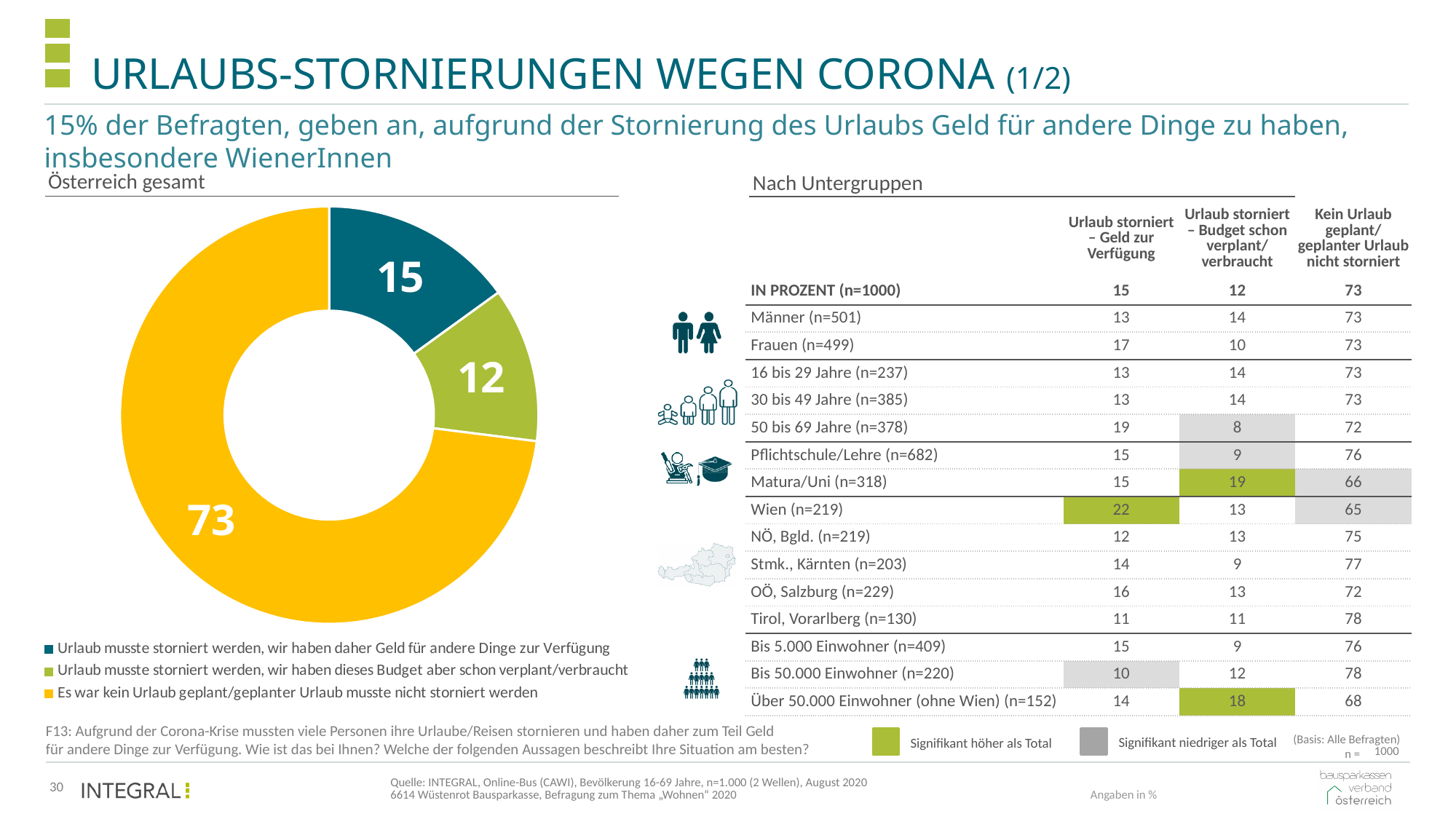
In the "Österreich gesamt" chart, which colour represents "Es war kein Urlaub geplant/geplanter Urlaub musste nicht storniert werden"? Yellow In the "Österreich gesamt" chart, what share of respondents had no holiday planned or did not have to cancel it? 73% In the "Österreich gesamt" chart, what value is shown for "Urlaub musste storniert werden, wir haben daher Geld für andere Dinge zur Verfügung"? 15 In the "Österreich gesamt" chart, what is the combined value of the two slices for cancelled holidays (15 and 12)? 27 In the "Österreich gesamt" chart, which category has the smallest slice? Urlaub musste storniert werden, wir haben dieses Budget aber schon verplant/verbraucht In the "Österreich gesamt" chart, what is the difference between the largest slice (73) and the smallest slice (12)? 61 In the "Österreich gesamt" chart, what value is shown for "Urlaub musste storniert werden, wir haben dieses Budget aber schon verplant/verbraucht"? 12 In the "Österreich gesamt" chart, what value is shown for "Es war kein Urlaub geplant/geplanter Urlaub musste nicht storniert werden"? 73 What kind of chart is shown under "Österreich gesamt"? Pie chart (donut) In the "Österreich gesamt" chart, which is larger: the slice for "Geld für andere Dinge zur Verfügung" or the slice for "Budget aber schon verplant/verbraucht"? Geld für andere Dinge zur Verfügung (15) In the "Österreich gesamt" chart, which category has the largest slice? Es war kein Urlaub geplant/geplanter Urlaub musste nicht storniert werden How many slices does the "Österreich gesamt" chart have? 3